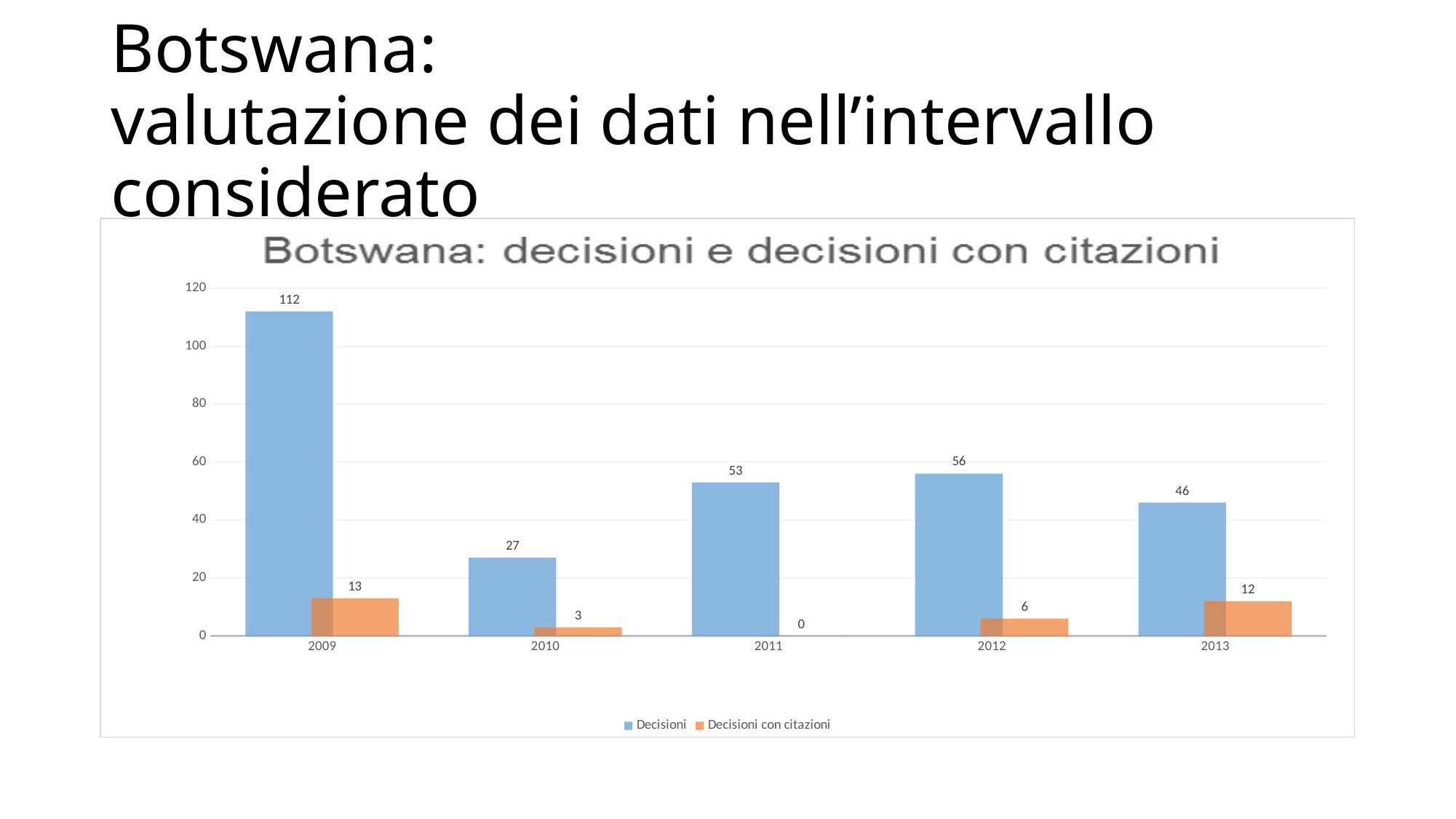
How many series does the legend list? 2 Which year has the highest value for Decisioni? 2009 What is the value of Decisioni con citazioni for 2013? 12 How many years are shown on the x axis? 5 What is the difference between Decisioni and Decisioni con citazioni in 2009? 99 Is the value of Decisioni for 2013 greater or less than 40? greater What is the difference between Decisioni in 2012 and Decisioni in 2011? 3 Which year has the lowest value for Decisioni? 2010 What is the value of Decisioni for 2009? 112 What kind of chart is shown on the slide? Bar chart Which is larger: Decisioni con citazioni in 2009 or in 2013? 2009 What is the value of Decisioni con citazioni for 2011? 0